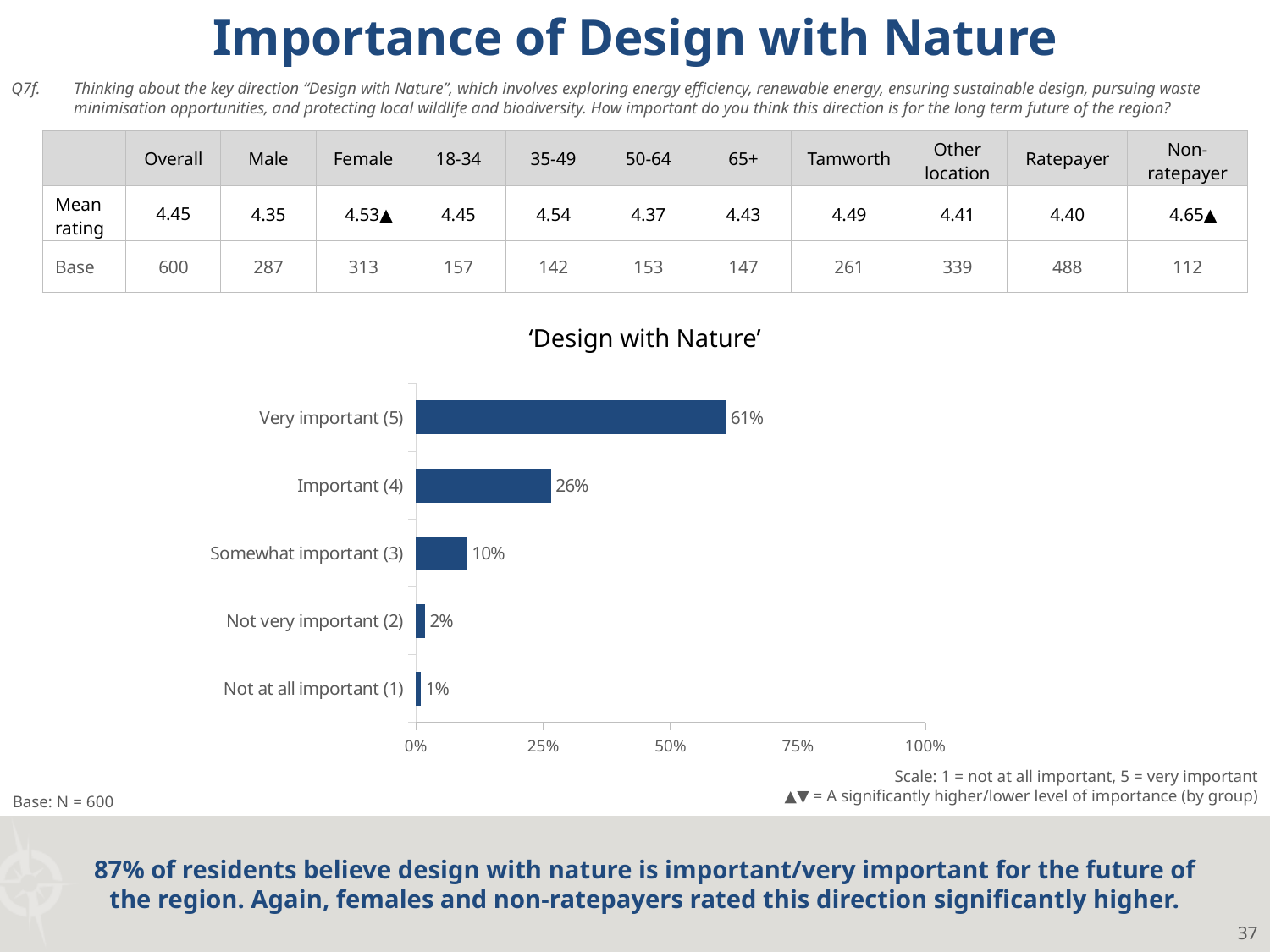
Which is larger: the percentage for Somewhat important (3) or Not very important (2)? Somewhat important (3) Which rating category has the highest percentage in the 'Design with Nature' chart? Very important (5) Which rating category has the lowest percentage in the 'Design with Nature' chart? Not at all important (1) What percentage of respondents rated 'Design with Nature' as Somewhat important (3)? 10% What is the title of the chart on the slide? 'Design with Nature' What percentage of respondents rated 'Design with Nature' as Not at all important (1)? 1% Is the value for Very important (5) greater or less than 50%? greater What percentage of respondents rated 'Design with Nature' as Important (4)? 26% How many rating categories are shown in the 'Design with Nature' chart? 5 What percentage of respondents rated 'Design with Nature' as Very important (5)? 61% What type of chart is used to show the 'Design with Nature' ratings? Bar chart What is the difference in percentage points between Very important (5) and Important (4)? 35